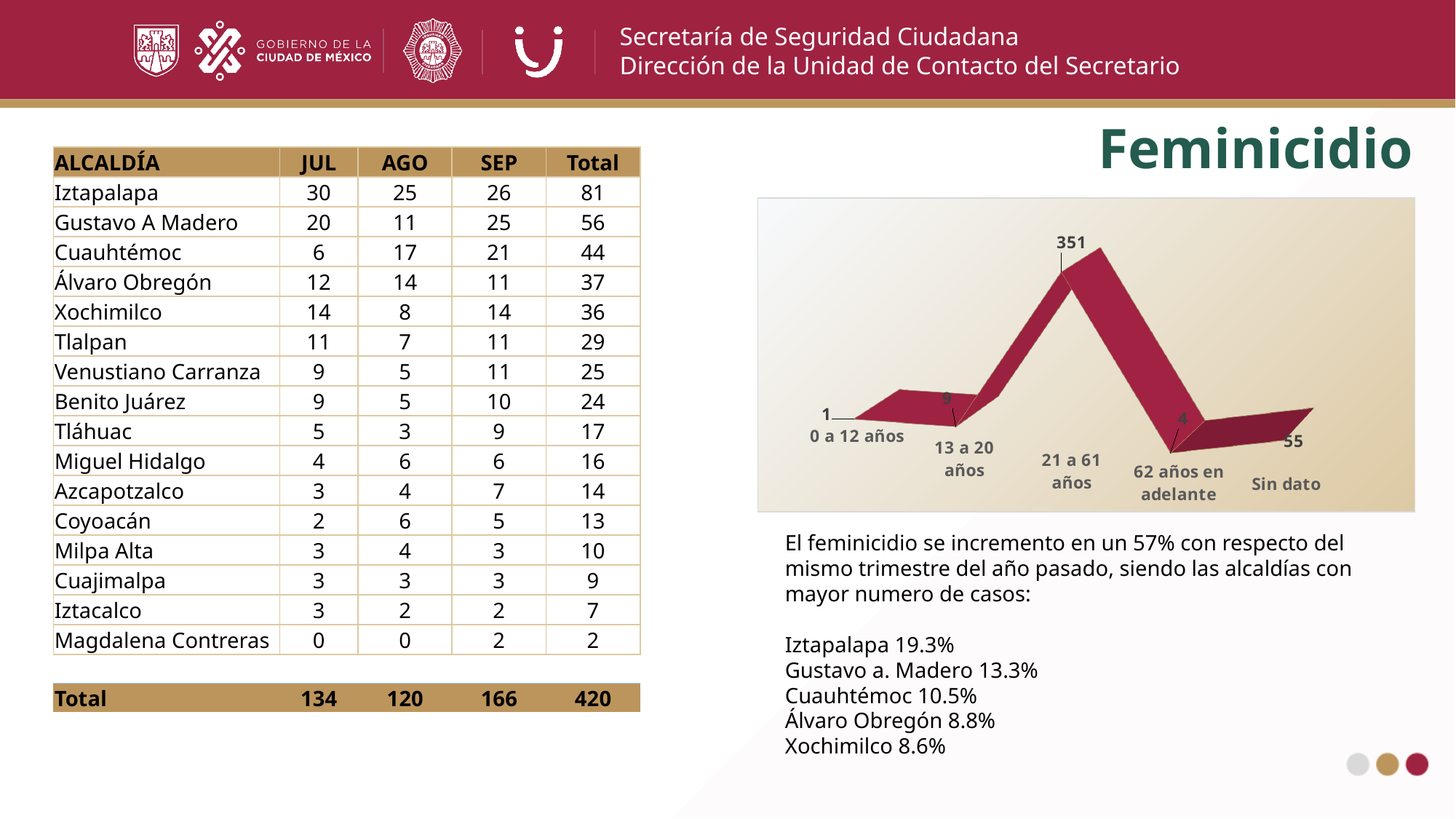
What kind of chart is shown on the slide? line chart Which category has the lowest value on the chart? 0 a 12 años What is the title shown above the chart on the slide? Feminicidio What is the value for the "Sin dato" category? 55 What is the value for the "13 a 20 años" category? 9 What is the value for the "21 a 61 años" category? 351 What is the value for the "62 años en adelante" category? 4 Which category has the highest value on the chart? 21 a 61 años What is the difference between the values for "21 a 61 años" and "Sin dato"? 296 What is the value for the "0 a 12 años" category? 1 Which is larger, the value for "13 a 20 años" or the value for "62 años en adelante"? 13 a 20 años How many age categories are plotted on the chart? 5